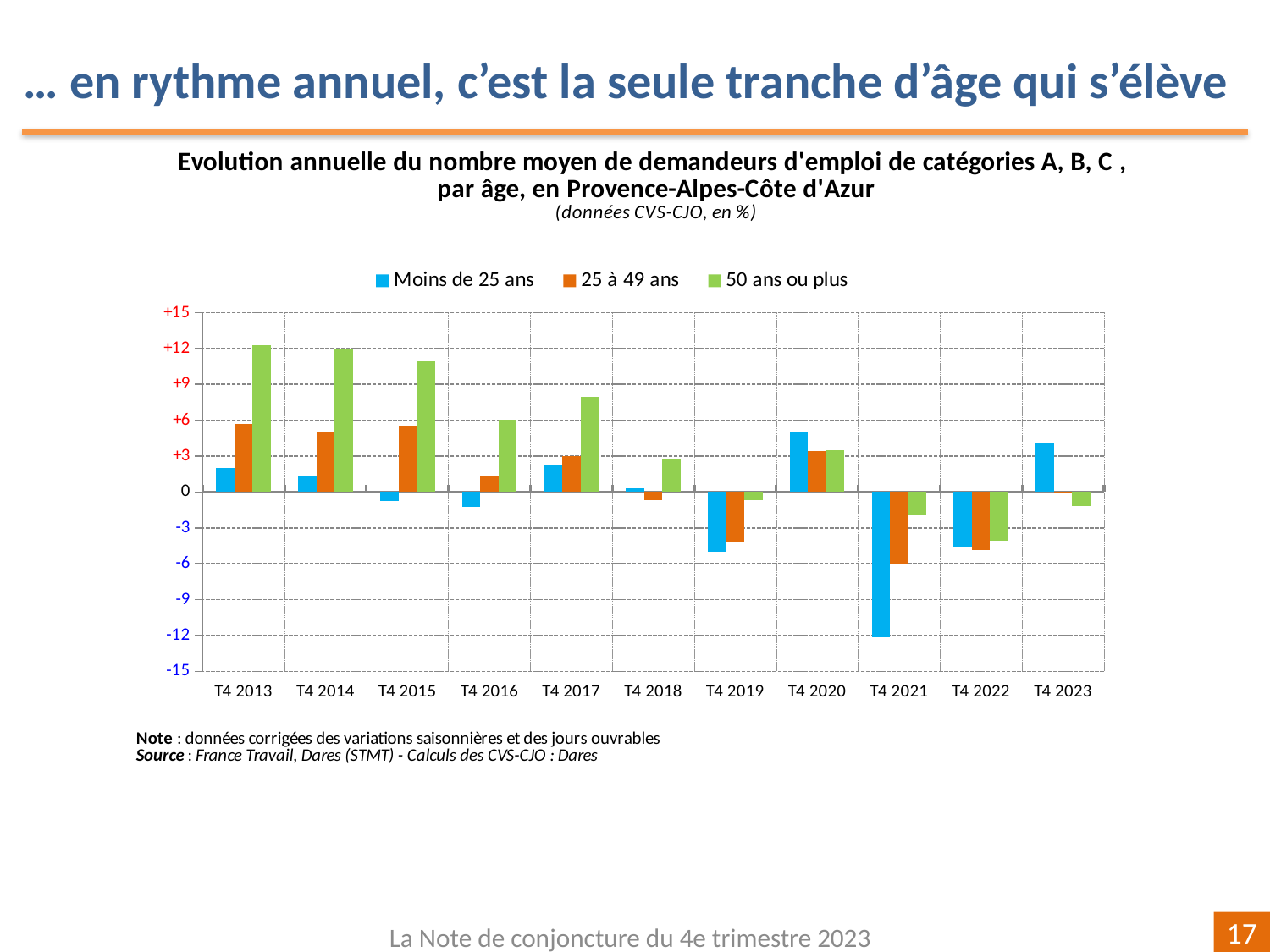
How many series does the legend list? 3 Is the value for '50 ans ou plus' in T4 2017 greater or less than +6? greater In T4 2020, which is larger: the value for 'Moins de 25 ans' or for '25 à 49 ans'? Moins de 25 ans Is the value for '50 ans ou plus' in T4 2013 greater or less than +9? greater In which period is the value for 'Moins de 25 ans' the lowest? T4 2021 Which series has the highest value in T4 2015? 50 ans ou plus How many periods (T4 years) are shown on the x axis? 11 Is the value for '25 à 49 ans' in T4 2021 greater or less than -3? less Do the values for '50 ans ou plus' rise or fall from T4 2013 to T4 2016? fall What colour represents the '50 ans ou plus' series in the legend? green What kind of chart is shown on the slide? bar chart